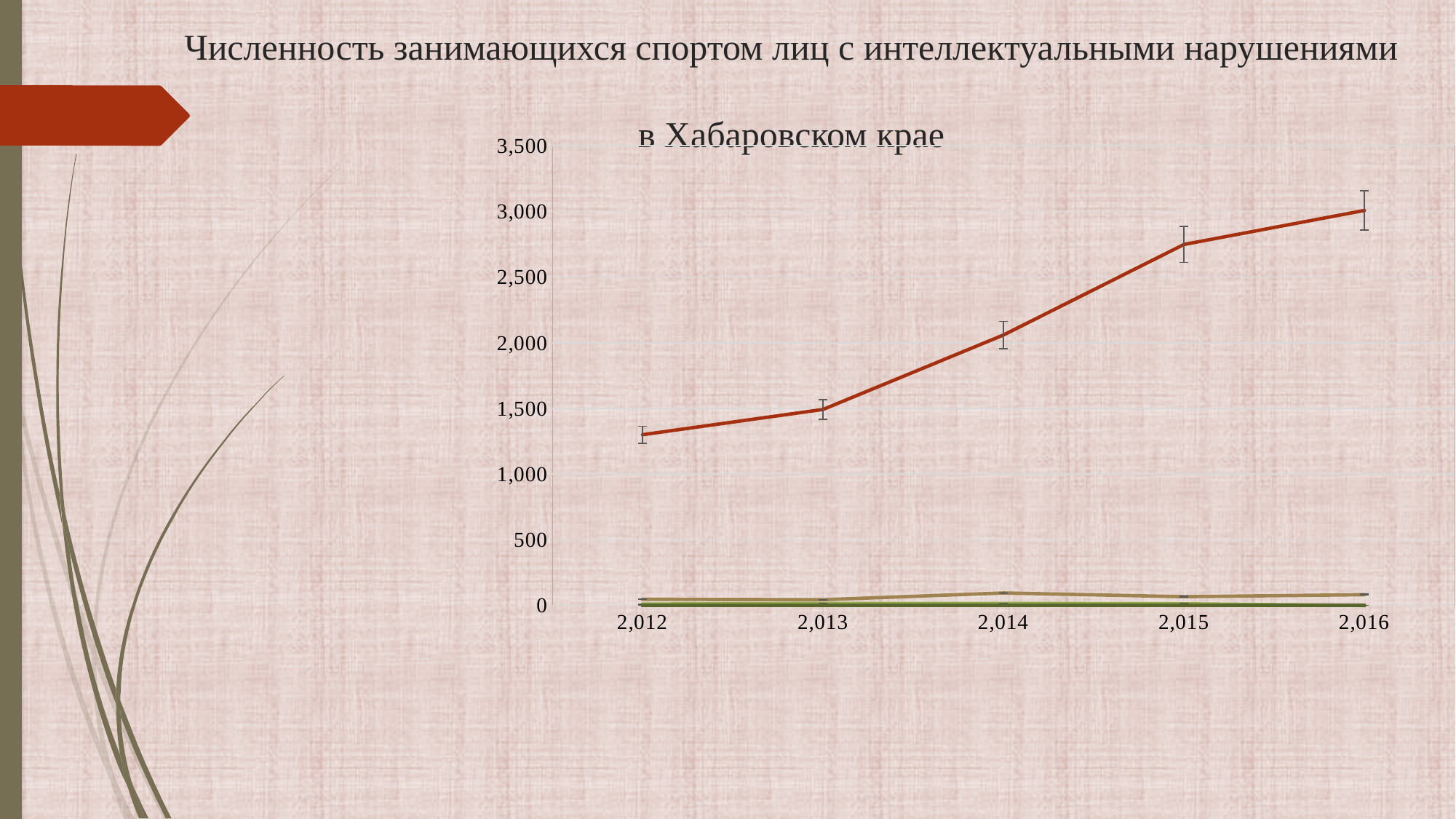
Is the value of the red line for 2,016 greater or less than 2,500? greater Does the red line rise or fall from 2,012 to 2,016? rise Is the value of the red line for 2,014 greater or less than 2,500? less In which year does the red line reach its highest value? 2,016 Is the value of the red line for 2,012 greater or less than 1,000? greater What kind of chart is shown on the slide? line chart How many years are plotted along the x axis? 5 What is the title of the chart? Численность занимающихся спортом лиц с интеллектуальными нарушениями в Хабаровском крае In which year does the red line have its lowest value? 2,012 Which year has the larger value on the red line, 2,013 or 2,015? 2,015